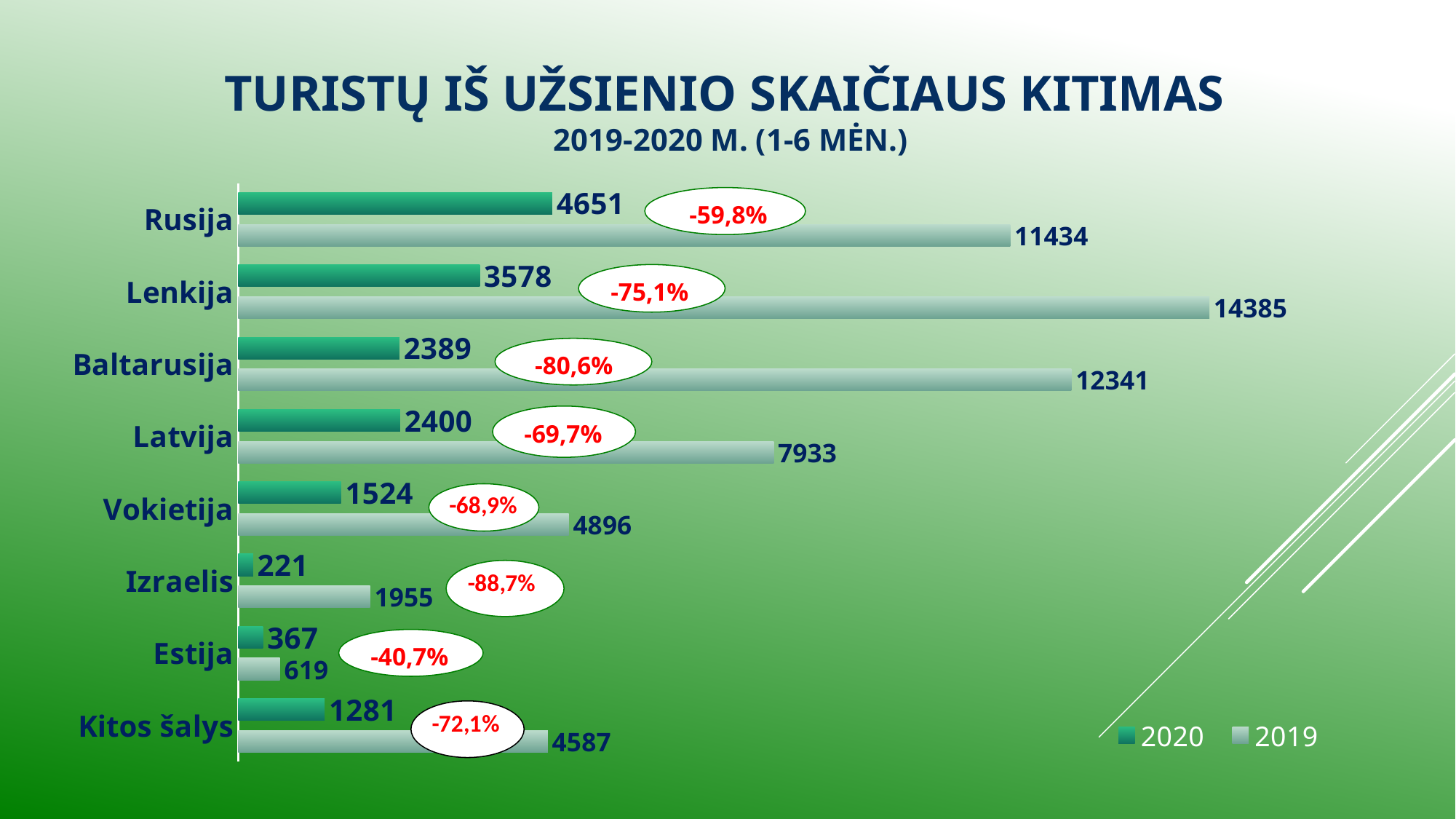
What percentage change is shown in the oval for Estija? -40,7% How many categories are shown on the chart? 8 Which category has the lowest 2020 value? Izraelis Which category has the highest 2019 value? Lenkija What is the 2019 value for Lenkija? 14385 What is the 2019 value for Latvija? 7933 What is the title of the chart? TURISTŲ IŠ UŽSIENIO SKAIČIAUS KITIMAS 2019-2020 M. (1-6 MĖN.) What is the difference between the 2019 and 2020 values for Vokietija? 3372 How many series does the legend list? 2 What kind of chart is shown on the slide? Bar chart Which is larger, the 2020 value for Baltarusija or the 2020 value for Lenkija? Lenkija What is the 2020 value for Rusija? 4651